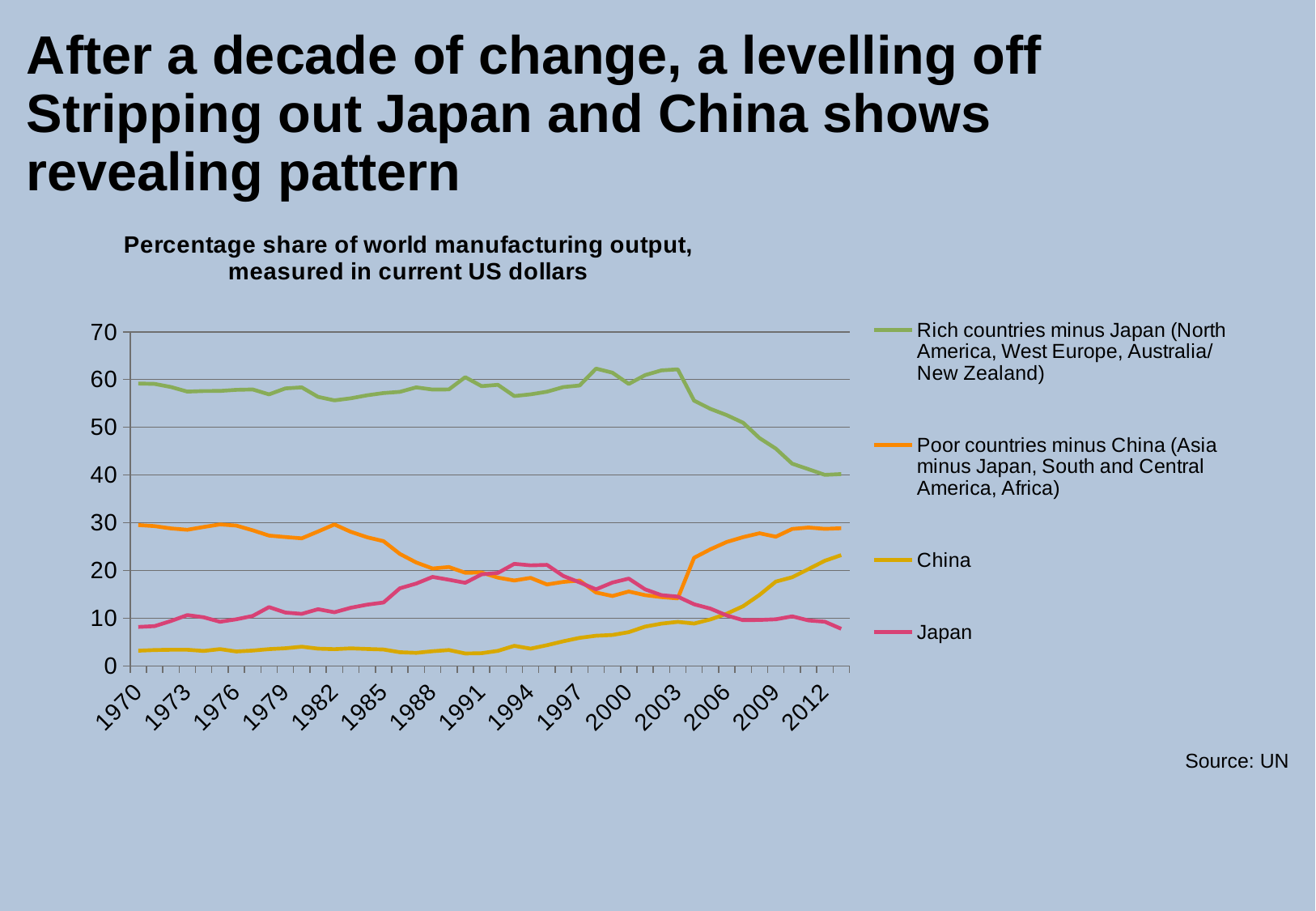
What is the source cited for the chart? UN What kind of chart is shown on the slide? Line chart Which series has the lowest value in 1970? China Which series has the highest value in 1970? Rich countries minus Japan (North America, West Europe, Australia/New Zealand) Does the value for Rich countries minus Japan rise or fall between 2003 and 2012? Fall How many year labels are shown on the x axis? 15 In 2012, which is larger: the value for China or the value for Japan? China Is the value for Rich countries minus Japan in 2012 greater or less than 50? less Does the value for China rise or fall between 2003 and 2012? Rise Is the value for China in 1970 greater or less than 10? less How many series does the legend list? 4 Is the value for Rich countries minus Japan in 1970 greater or less than 50? greater